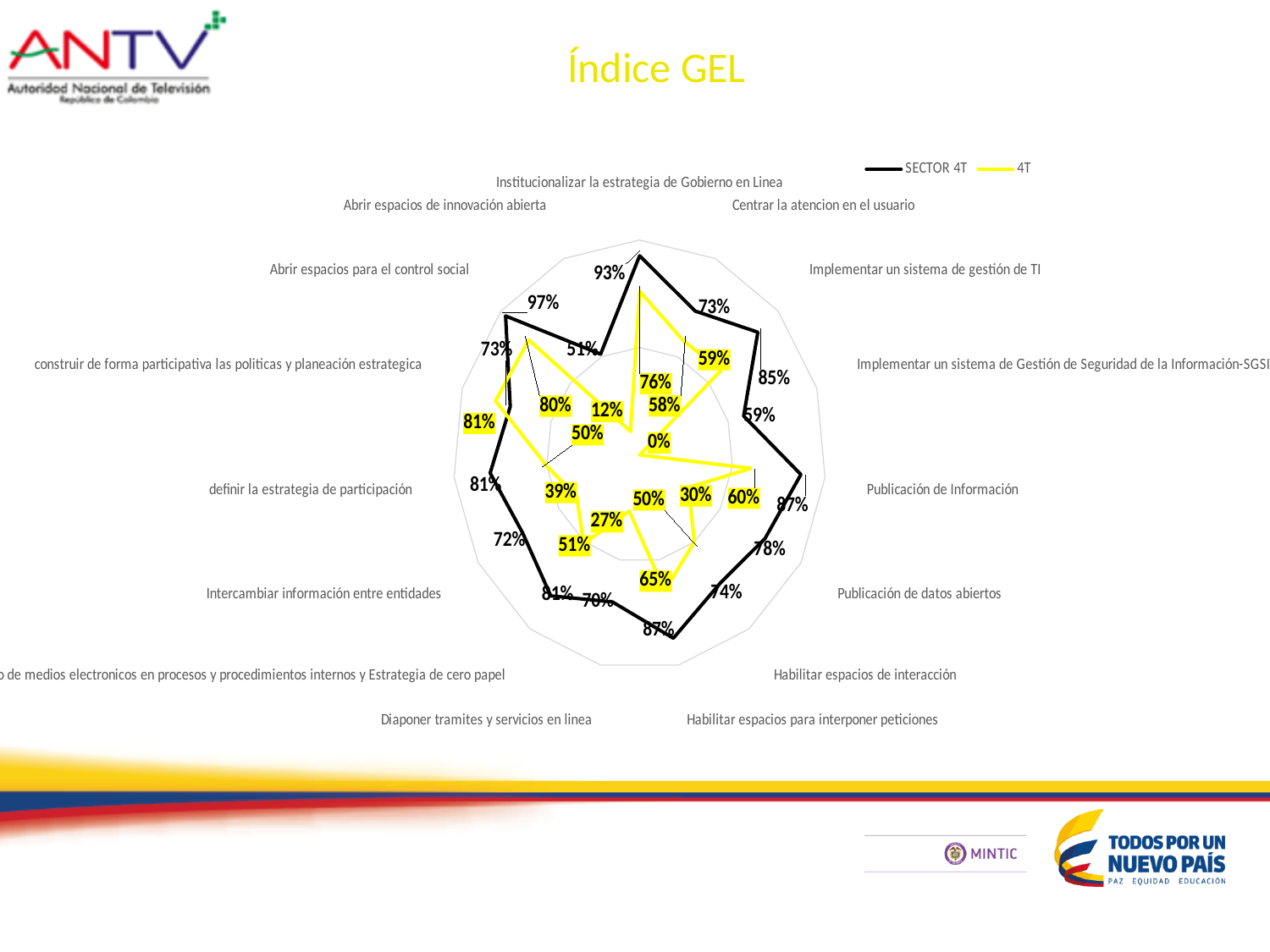
How many series does the legend of the Índice GEL chart list? 2 How many categories are plotted around the radar chart? 15 What is the SECTOR 4T value for 'Institucionalizar la estrategia de Gobierno en Linea'? 93% Which category has the lowest 4T value? Implementar un sistema de Gestión de Seguridad de la Información-SGSI Which category has the highest SECTOR 4T value? Abrir espacios para el control social For 'Institucionalizar la estrategia de Gobierno en Linea', which series has the larger value, SECTOR 4T or 4T? SECTOR 4T What is the SECTOR 4T value for 'Abrir espacios para el control social'? 97% What kind of chart is shown on the slide? Radar chart What is the title of the chart on the slide? Índice GEL What is the 4T value for 'Implementar un sistema de Gestión de Seguridad de la Información-SGSI'? 0% What are the two series named in the legend of the chart? SECTOR 4T and 4T What is the SECTOR 4T value for 'Implementar un sistema de gestión de TI'? 85%